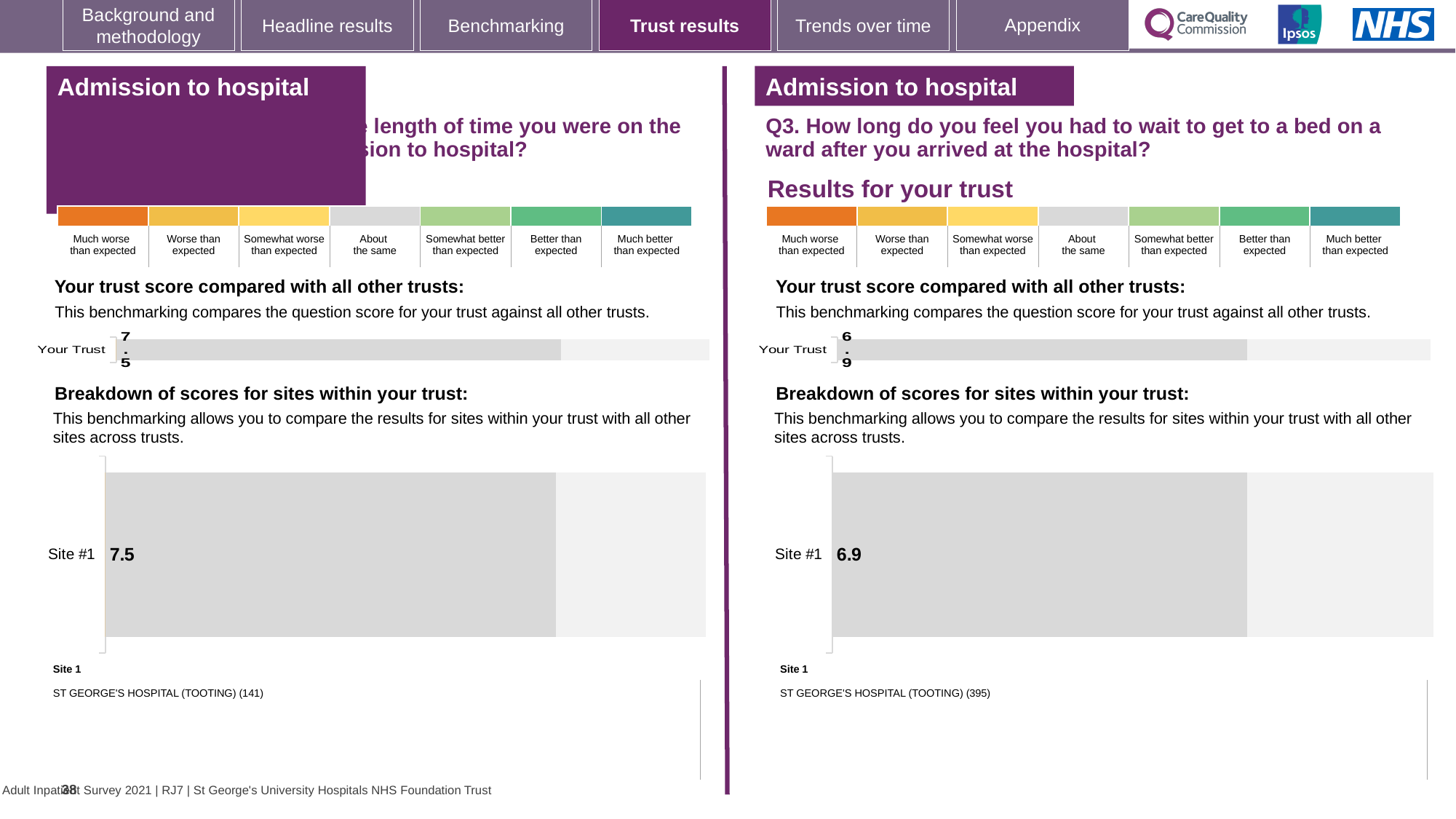
In the right-hand 'Breakdown of scores for sites within your trust' chart, what is the score for Site #1? 6.9 What kind of chart is used for the 'Breakdown of scores for sites within your trust' on the right-hand side? Bar chart How many sites are shown in the left-hand 'Breakdown of scores for sites within your trust' chart? 1 Comparing the Site #1 bars in the left-hand and right-hand site breakdown charts, which has the higher score? The left-hand chart (7.5) In the right-hand site breakdown chart, which hospital is listed as Site 1? ST GEORGE'S HOSPITAL (TOOTING) (395) In the right-hand 'Your trust score compared with all other trusts' chart (Q3), what is the value for Your Trust? 6.9 In the left-hand 'Your trust score compared with all other trusts' chart, what is the value for Your Trust? 7.5 In the left-hand 'Breakdown of scores for sites within your trust' chart, what is the score for Site #1? 7.5 What is the difference between the Site #1 score in the left-hand site breakdown chart and the Site #1 score in the right-hand site breakdown chart? 0.6 In the left-hand charts, is the Your Trust score the same as the Site #1 score? Yes, both are 7.5 What number appears in parentheses after the Site 1 hospital name below the left-hand site breakdown chart? 141